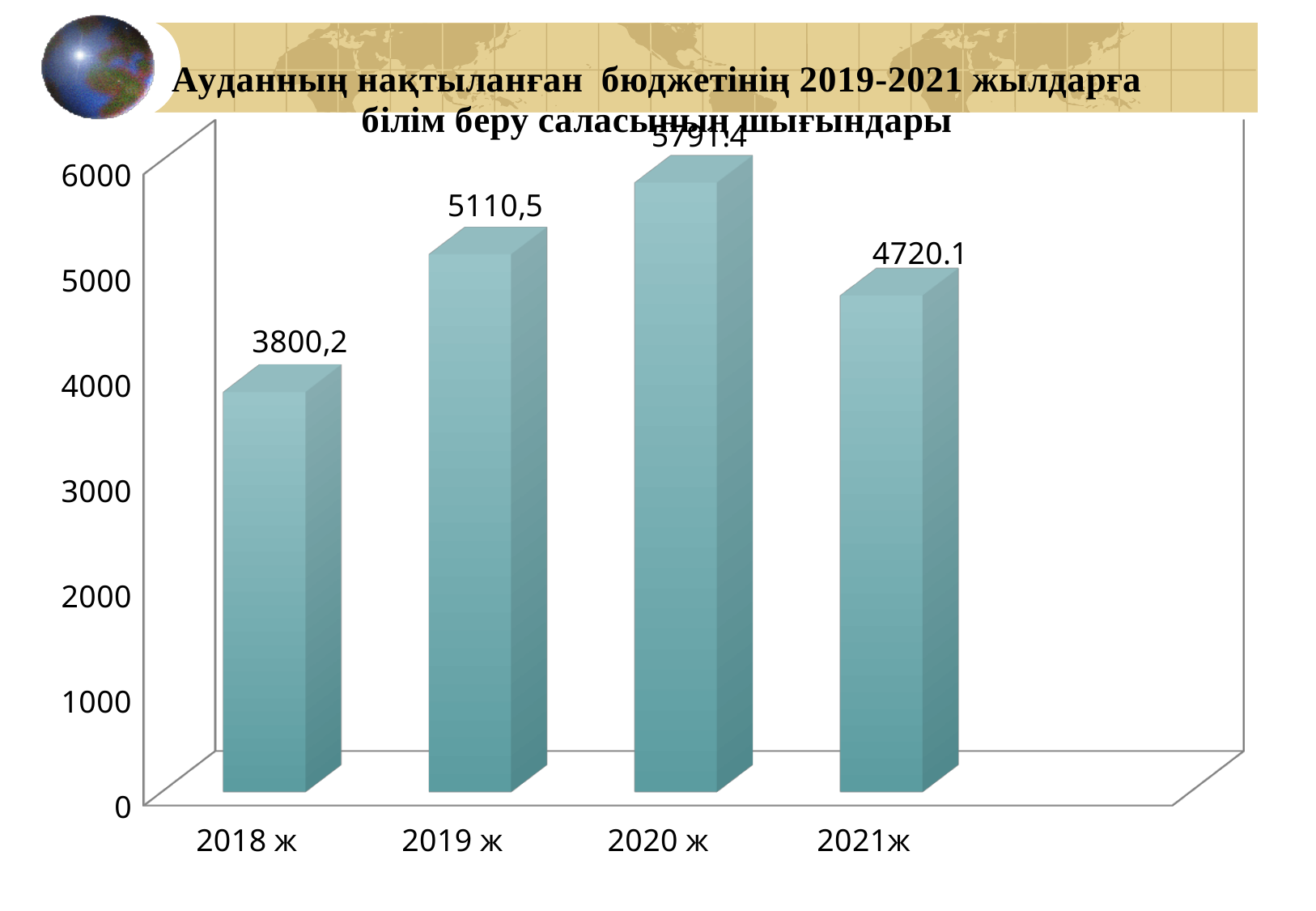
Is the value for 2018 ж greater or less than 4000? less What is the value shown for 2018 ж? 3800,2 Is the value for 2021ж greater or less than 4000? greater What kind of chart is shown on the slide? bar chart What is the value shown for 2019 ж? 5110,5 Which year has the highest bar? 2020 ж Which year has the lowest bar? 2018 ж Which is larger, the value for 2019 ж or the value for 2021ж? 2019 ж What is the difference between the values for 2019 ж and 2018 ж? 1310,3 What is the value shown for 2021ж? 4720.1 How many years are shown on the x axis? 4 Do the values rise or fall from 2018 ж to 2020 ж? rise